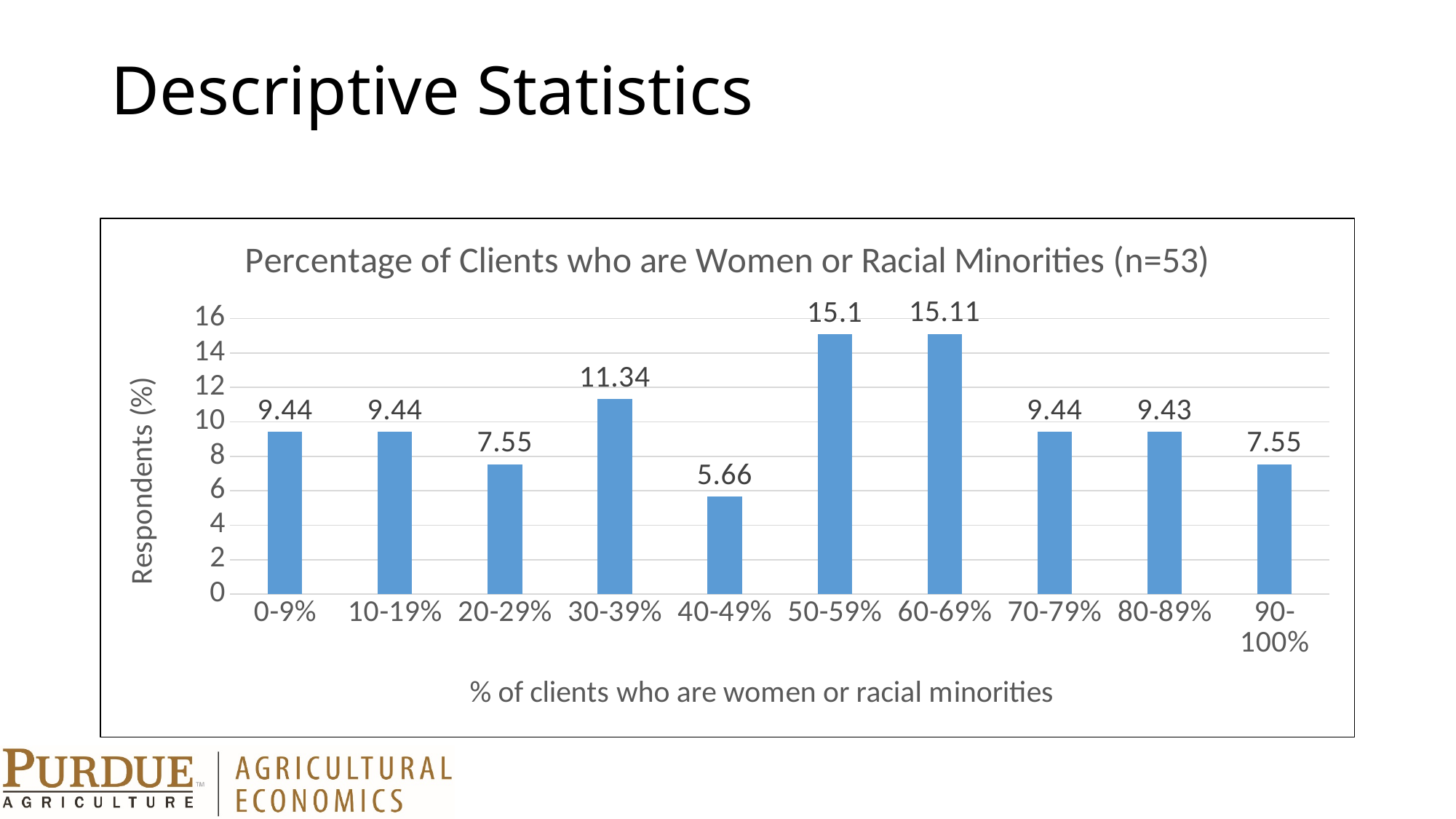
Which is larger, the value for 30-39% or the value for 70-79%? 30-39% What is the value for the 30-39% category? 11.34 What kind of chart is shown on the slide? bar chart What is the value for the 90-100% category? 7.55 What is the title of the chart? Percentage of Clients who are Women or Racial Minorities (n=53) What is the difference between the values for 60-69% and 20-29%? 7.56 Which category has the lowest value? 40-49% How many categories are shown on the x axis? 10 What is the value for the 50-59% category? 15.1 What is the value for the 40-49% category? 5.66 Is the value for 60-69% greater or less than 14? greater What is the difference between the values for 30-39% and 40-49%? 5.68